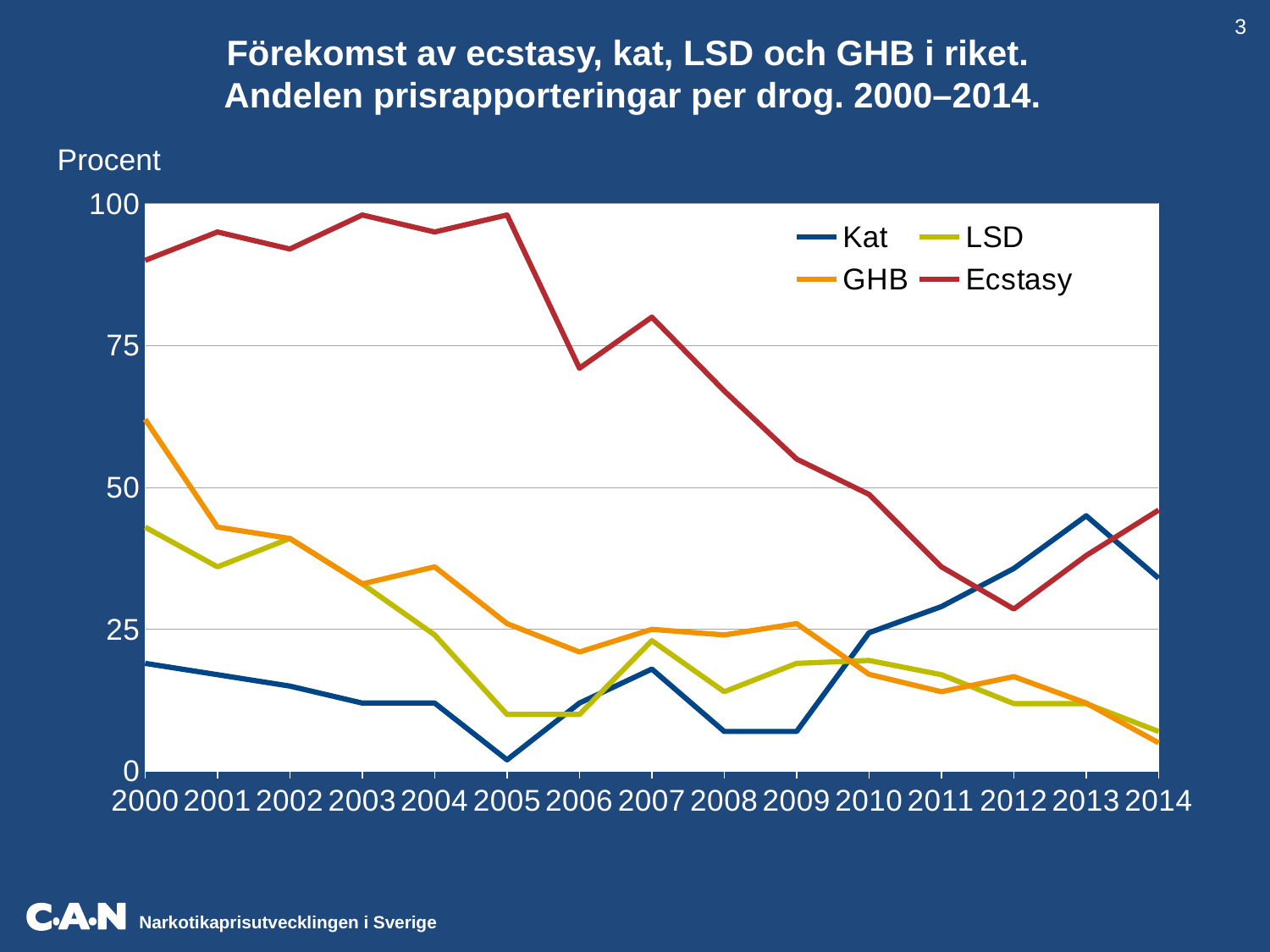
How many years are plotted along the x axis? 15 Which series has the highest value in 2000? Ecstasy Which series has the lowest value in 2005? Kat Is the value for Kat in 2005 greater or less than 25? less What kind of chart is shown on the slide? Line chart Which is larger in 2014, the value for Kat or the value for GHB? Kat Is the value for Ecstasy in 2000 greater or less than 75? greater How many series does the legend list? 4 Does the Ecstasy series rise or fall between 2005 and 2012? Fall Is the value for LSD in 2014 greater or less than 25? less What label is shown on the vertical axis? Procent